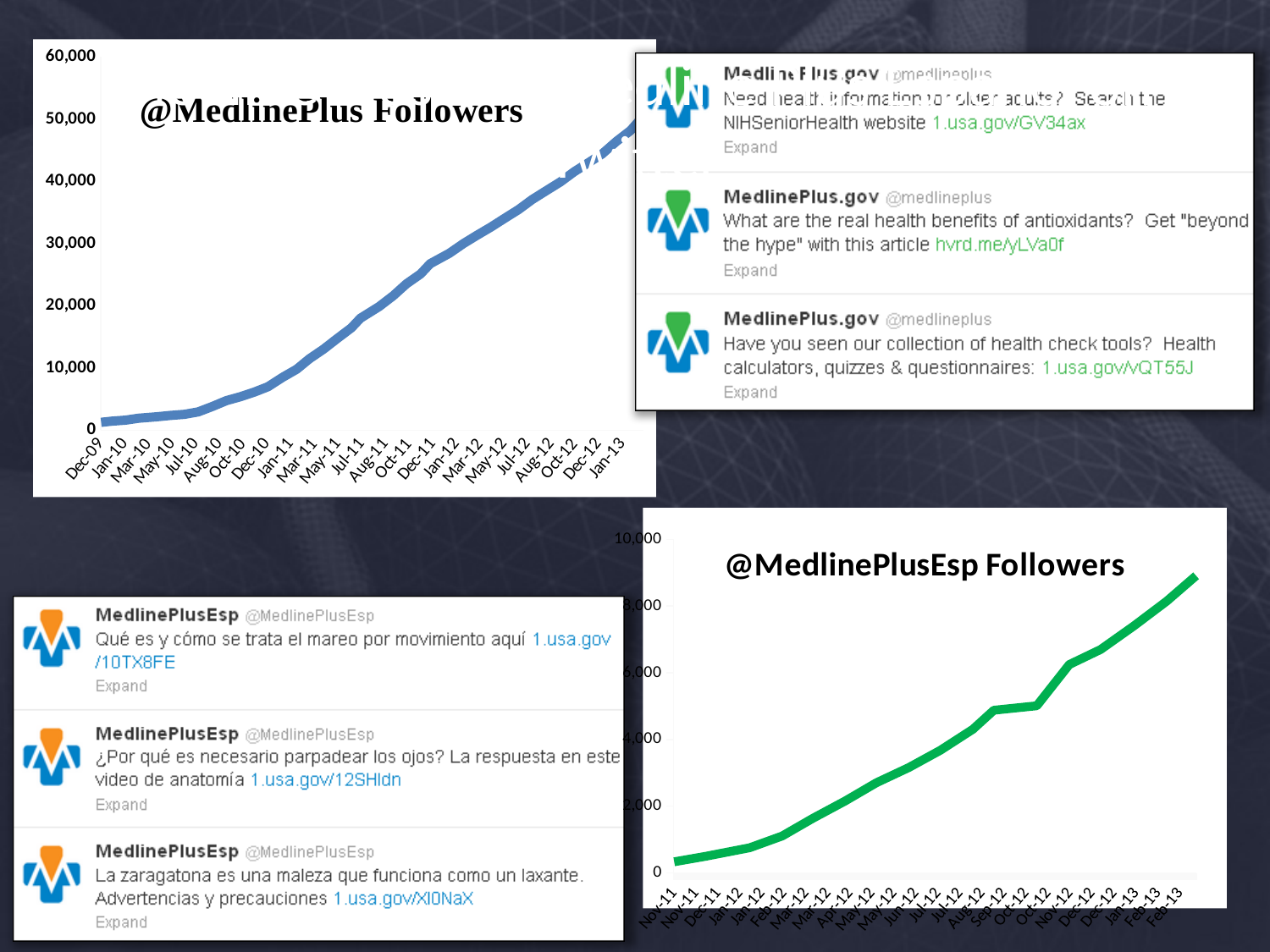
What kind of chart is the @MedlinePlus Followers chart? line chart In the @MedlinePlus Followers chart, is the value for Dec-11 greater or less than 20,000? greater In the @MedlinePlus Followers chart, is the value for Dec-10 greater or less than 10,000? less In the @MedlinePlusEsp Followers chart, is the value for Nov-11 greater or less than 2,000? less In the @MedlinePlus Followers chart, do the values rise or fall from Dec-09 to Jan-13? rise In the @MedlinePlusEsp Followers chart, do the values rise or fall from Nov-11 to Feb-13? rise What colour is the line in the @MedlinePlusEsp Followers chart? green What is the highest value shown on the y axis of the @MedlinePlusEsp Followers chart? 10,000 What kind of chart is the @MedlinePlusEsp Followers chart? line chart